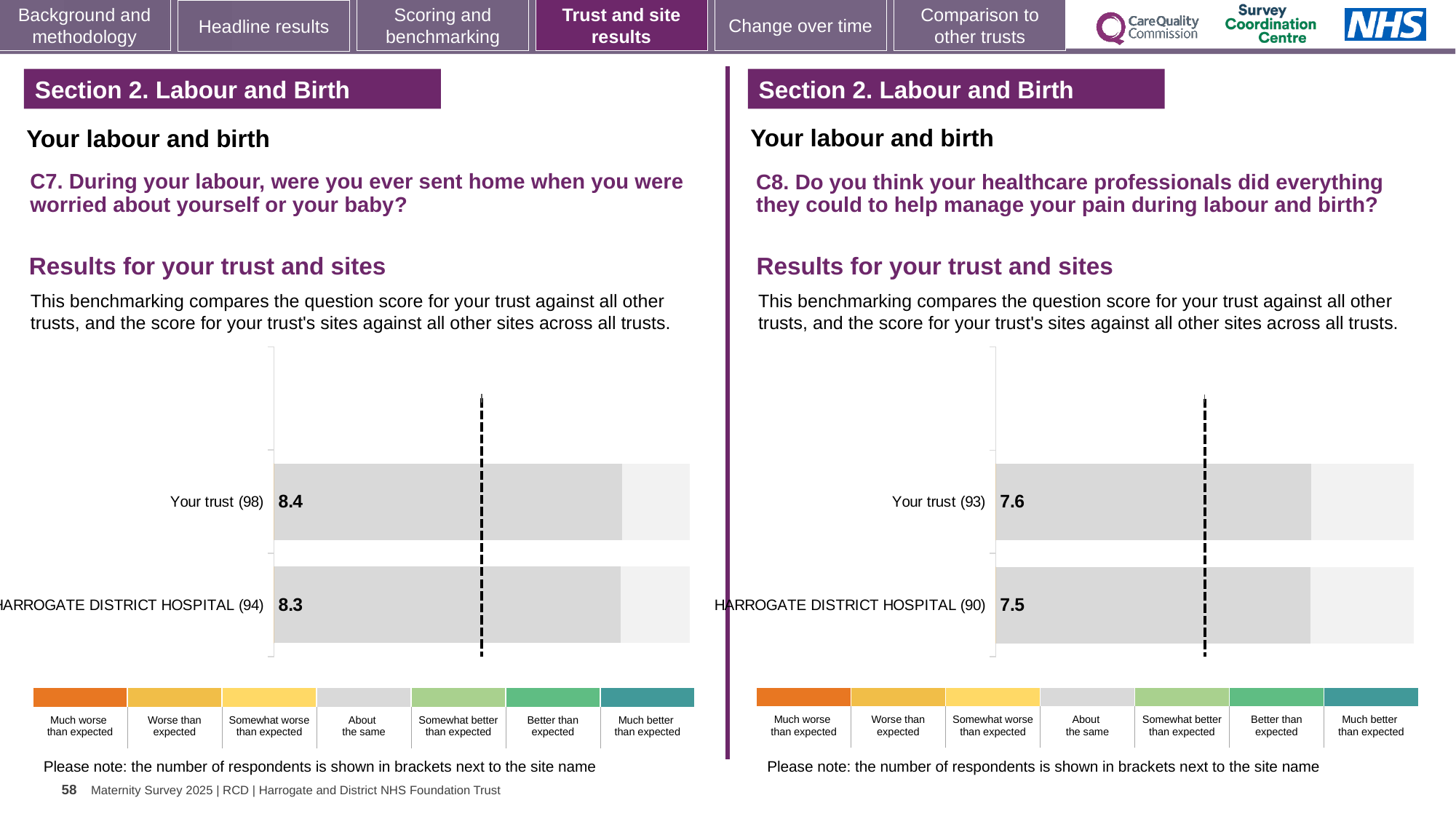
In the C8 chart on the right, what is the score for Your trust? 7.6 How many bars are plotted in the C7 chart on the left? 2 In the C8 chart on the right, what is the score for Harrogate District Hospital? 7.5 In the C7 chart on the left, which has the higher score, Your trust or Harrogate District Hospital? Your trust In the C8 chart on the right, which has the lower score, Your trust or Harrogate District Hospital? Harrogate District Hospital In the C8 chart on the right, how many respondents are shown in brackets for Harrogate District Hospital? 90 What type of chart is used in the C8 chart on the right? Bar chart In the C7 chart on the left, what is the score for Your trust? 8.4 In the C7 chart on the left, what is the difference between the Your trust score and the Harrogate District Hospital score? 0.1 In the C8 chart on the right, what is the difference between the Your trust score and the Harrogate District Hospital score? 0.1 In the C7 chart on the left, how many respondents are shown in brackets for Your trust? 98 In the C7 chart on the left, what is the score for Harrogate District Hospital? 8.3